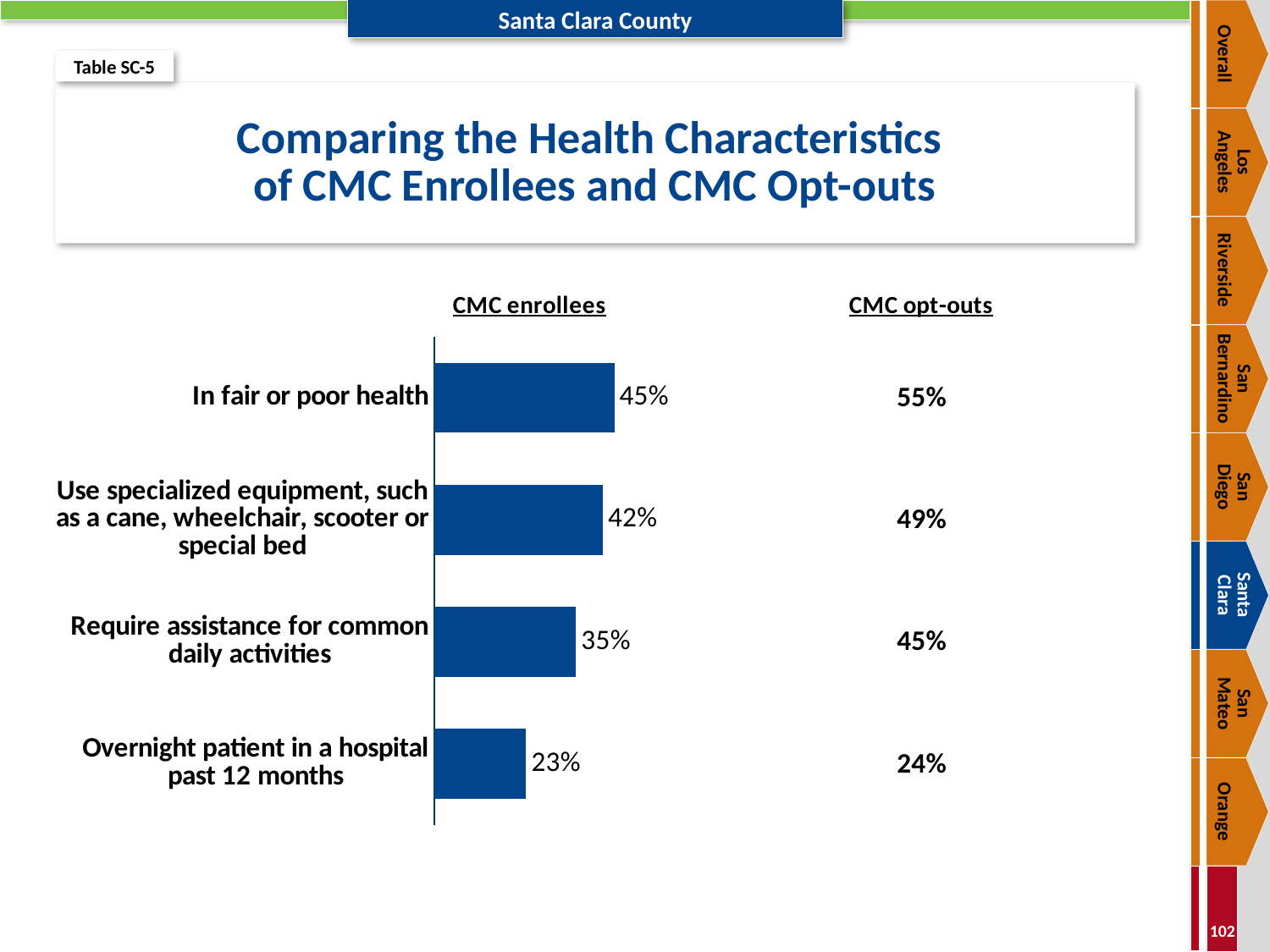
What type of chart is used to show the CMC enrollees values? Bar chart What is the title of the chart? Comparing the Health Characteristics of CMC Enrollees and CMC Opt-outs Which group has a higher percentage using specialized equipment, CMC enrollees or CMC opt-outs? CMC opt-outs What is the difference between CMC opt-outs and CMC enrollees for 'In fair or poor health'? 10% What percentage of CMC enrollees are in fair or poor health? 45% How many health characteristics are shown in the chart? 4 What percentage of CMC opt-outs require assistance for common daily activities? 45% What is the difference between CMC opt-outs and CMC enrollees for 'Require assistance for common daily activities'? 10% Which health characteristic has the lowest percentage among CMC opt-outs? Overnight patient in a hospital past 12 months What percentage of CMC enrollees were an overnight patient in a hospital in the past 12 months? 23% Which health characteristic has the highest percentage among CMC enrollees? In fair or poor health What percentage of CMC opt-outs use specialized equipment, such as a cane, wheelchair, scooter or special bed? 49%